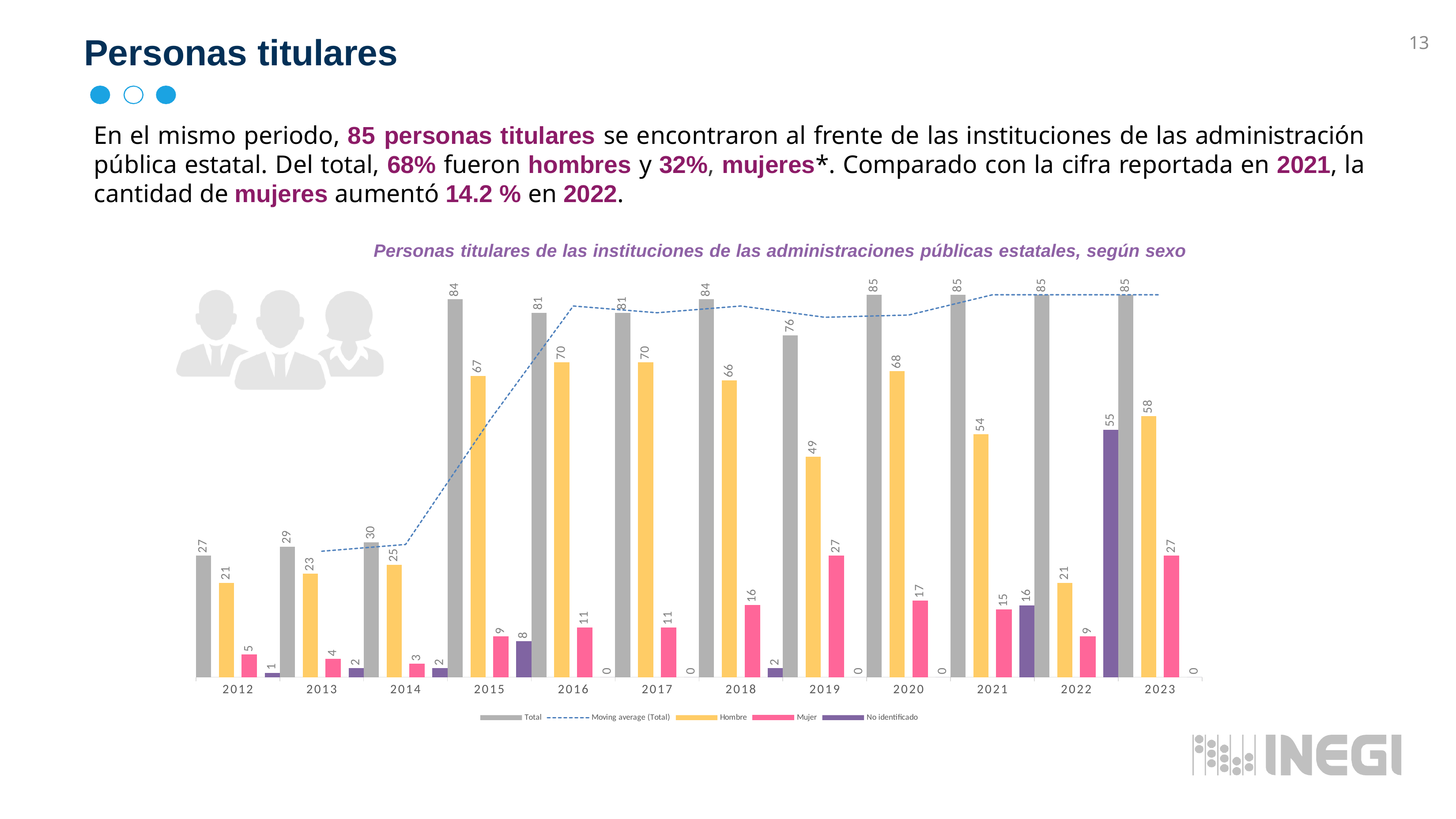
Which is larger, the Mujer value in 2019 or the Mujer value in 2020? 2019 What is the Hombre value for 2016? 70 How many series does the legend list? 5 What is the difference between the Hombre and Mujer values in 2023? 31 What is the Total value for 2019? 76 Which year has the highest Hombre value? 2016 and 2017 What colour are the Mujer bars? Pink What is the No identificado value for 2022? 55 Which year has the lowest Total value? 2012 How many years are shown on the x axis? 12 What is the Mujer value for 2018? 16 What kind of chart is this? Bar chart with a line